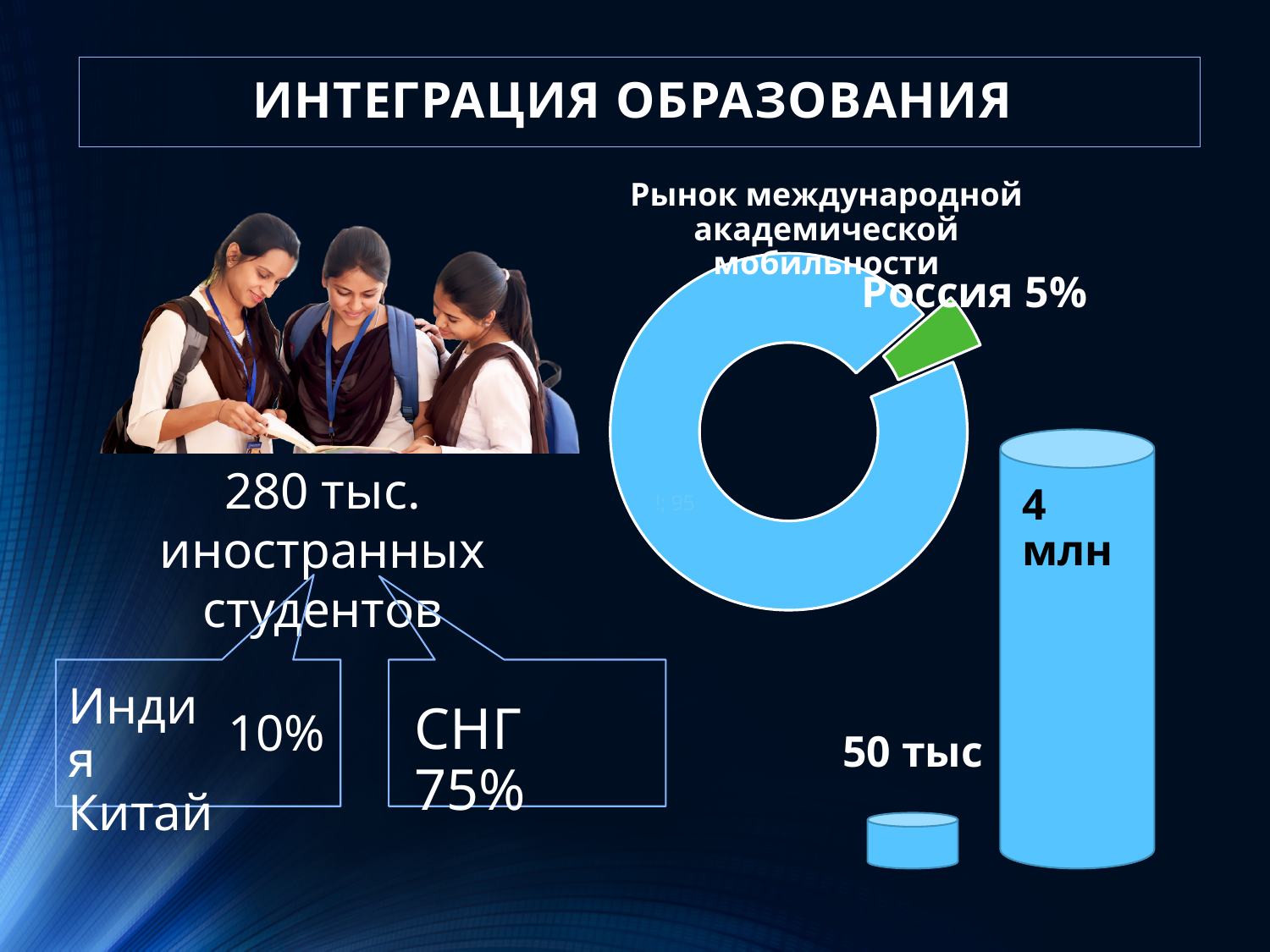
How many slices does the chart titled "Рынок международной академической мобильности" have? 2 In the chart titled "Рынок международной академической мобильности", what colour is the Россия slice? green What is the title of the doughnut chart on the slide? Рынок международной академической мобильности In the chart titled "Рынок международной академической мобильности", what share does Россия have? 5% In the cylinder bar chart at the bottom right of the slide, what value is labelled on the taller bar? 4 млн What kind of chart is the chart titled "Рынок международной академической мобильности"? doughnut chart What kind of chart is the chart at the bottom right of the slide showing 50 тыс and 4 млн? bar chart In the cylinder bar chart at the bottom right of the slide, what value is labelled on the shorter bar? 50 тыс In the cylinder bar chart at the bottom right of the slide, which is larger: 50 тыс or 4 млн? 4 млн How many bars are in the cylinder bar chart at the bottom right of the slide? 2 In the chart titled "Рынок международной академической мобильности", is the Россия slice the larger or the smaller of the two slices? smaller